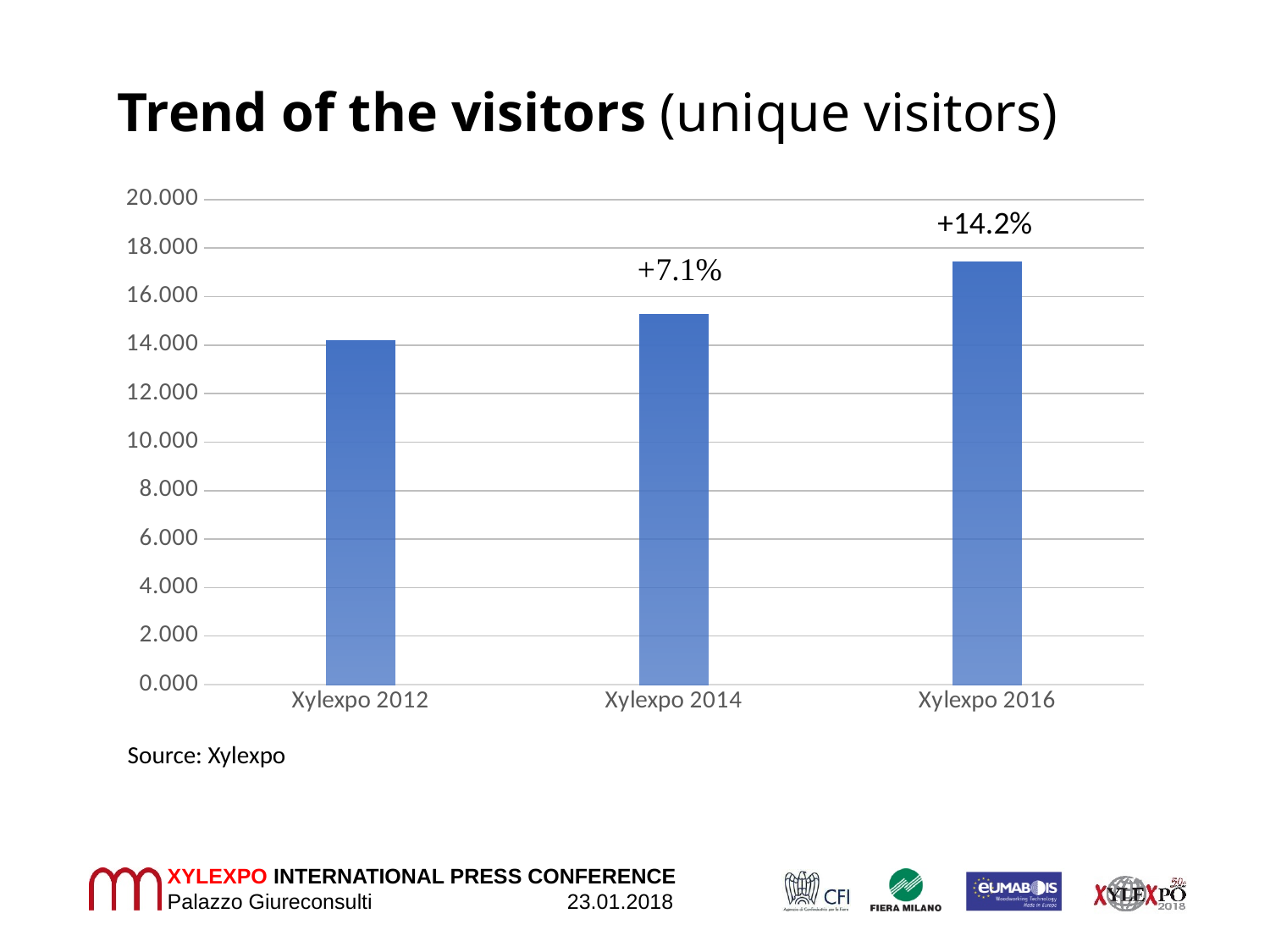
How many bars (categories) does the chart show? 3 Is the value for Xylexpo 2012 greater or less than 12.000? greater What kind of chart is shown on the slide? bar chart Which edition has the lowest number of unique visitors? Xylexpo 2012 Is the value for Xylexpo 2016 greater or less than 16.000? greater Which edition has the highest number of unique visitors? Xylexpo 2016 Which has more unique visitors, Xylexpo 2014 or Xylexpo 2016? Xylexpo 2016 What percentage change is printed above the Xylexpo 2014 bar? +7.1% What percentage change is printed above the Xylexpo 2016 bar? +14.2% Is the value for Xylexpo 2014 greater or less than 16.000? less Do the visitor numbers rise or fall from Xylexpo 2012 to Xylexpo 2016? rise